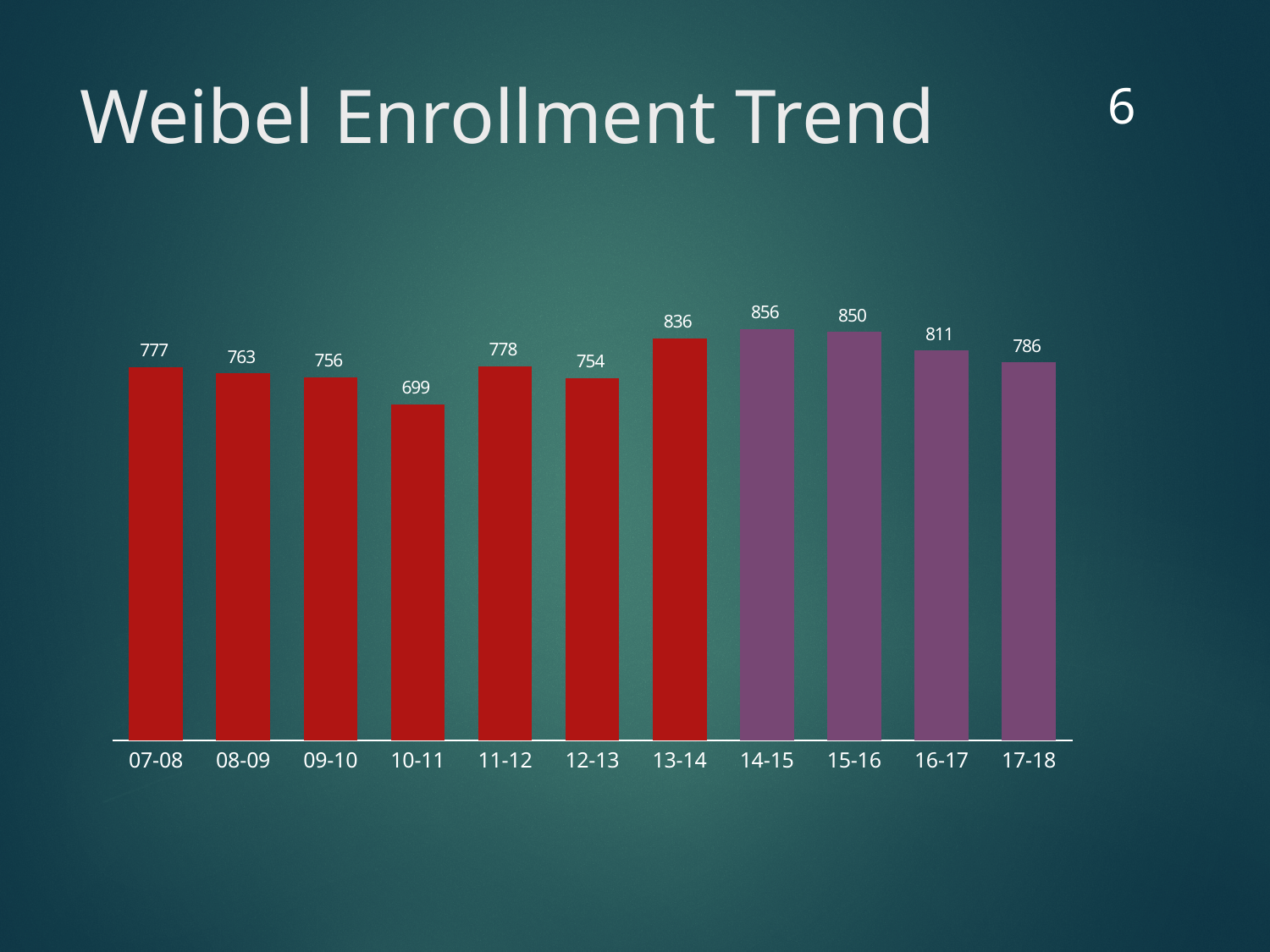
Which year has the highest enrollment? 14-15 What is the enrollment value for 14-15? 856 What is the difference between the enrollment in 13-14 and 10-11? 137 Which is larger, the enrollment in 07-08 or 12-13? 07-08 Which year has the lowest enrollment? 10-11 What is the difference between the enrollment in 14-15 and 17-18? 70 What is the title of the chart? Weibel Enrollment Trend What kind of chart is shown on the slide? bar chart What is the enrollment value for 17-18? 786 How many years are shown on the x axis? 11 What is the enrollment value for 10-11? 699 Do the enrollment values rise or fall from 14-15 to 17-18? fall